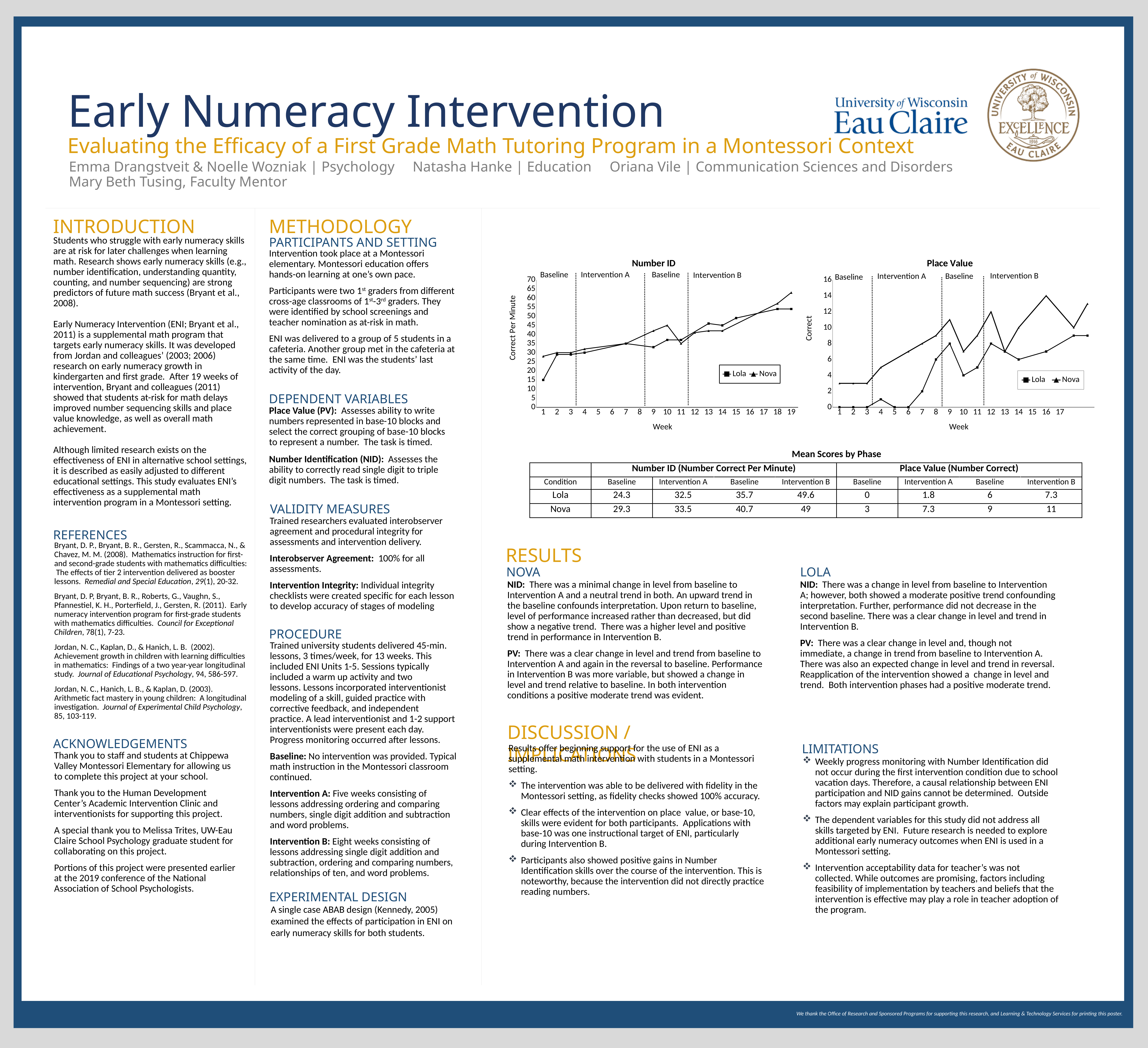
What is the y-axis title of the Number ID chart? Correct Per Minute In the Number ID chart, do the values generally rise or fall from week 1 to week 19? rise In the Number ID chart, is the Nova value at week 19 greater or less than 55? greater In the Number ID chart, how many weeks are shown on the x axis? 19 In the Place Value chart, how many weeks are shown on the x axis? 17 In the Place Value chart, which series has the higher value at week 16, Lola or Nova? Nova In the Place Value chart, is the Lola value at week 1 greater or less than 2? less In the Number ID chart, is the lowest value at week 1 greater or less than 20? less What are the two series named in the legend of the Number ID chart? Lola and Nova How many series does the legend of the Place Value chart list? 2 What kind of chart is the Number ID chart? line chart